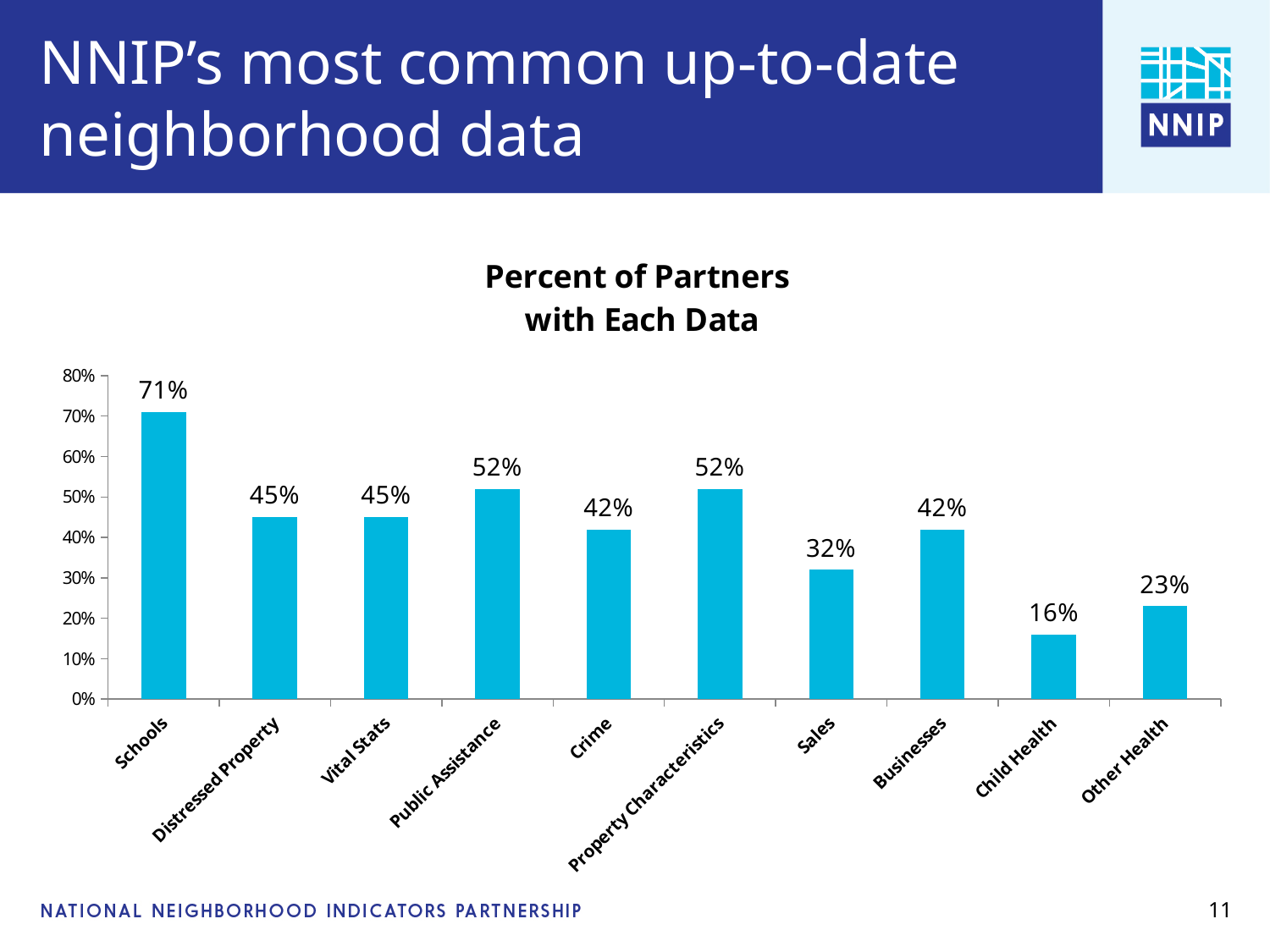
Which category has the highest percent of partners? Schools What is the value for Child Health? 16% Is the value for Property Characteristics greater or less than 50%? greater What is the title of the chart? Percent of Partners with Each Data Which category has the lowest percent of partners? Child Health What kind of chart is shown on the slide? Bar chart What percent of partners have Schools data? 71% How many categories are shown on the x axis? 10 What is the difference between the values for Public Assistance and Crime? 10% What is the difference between the values for Schools and Other Health? 48% Which is larger, the value for Businesses or the value for Sales? Businesses What percent of partners have Sales data? 32%